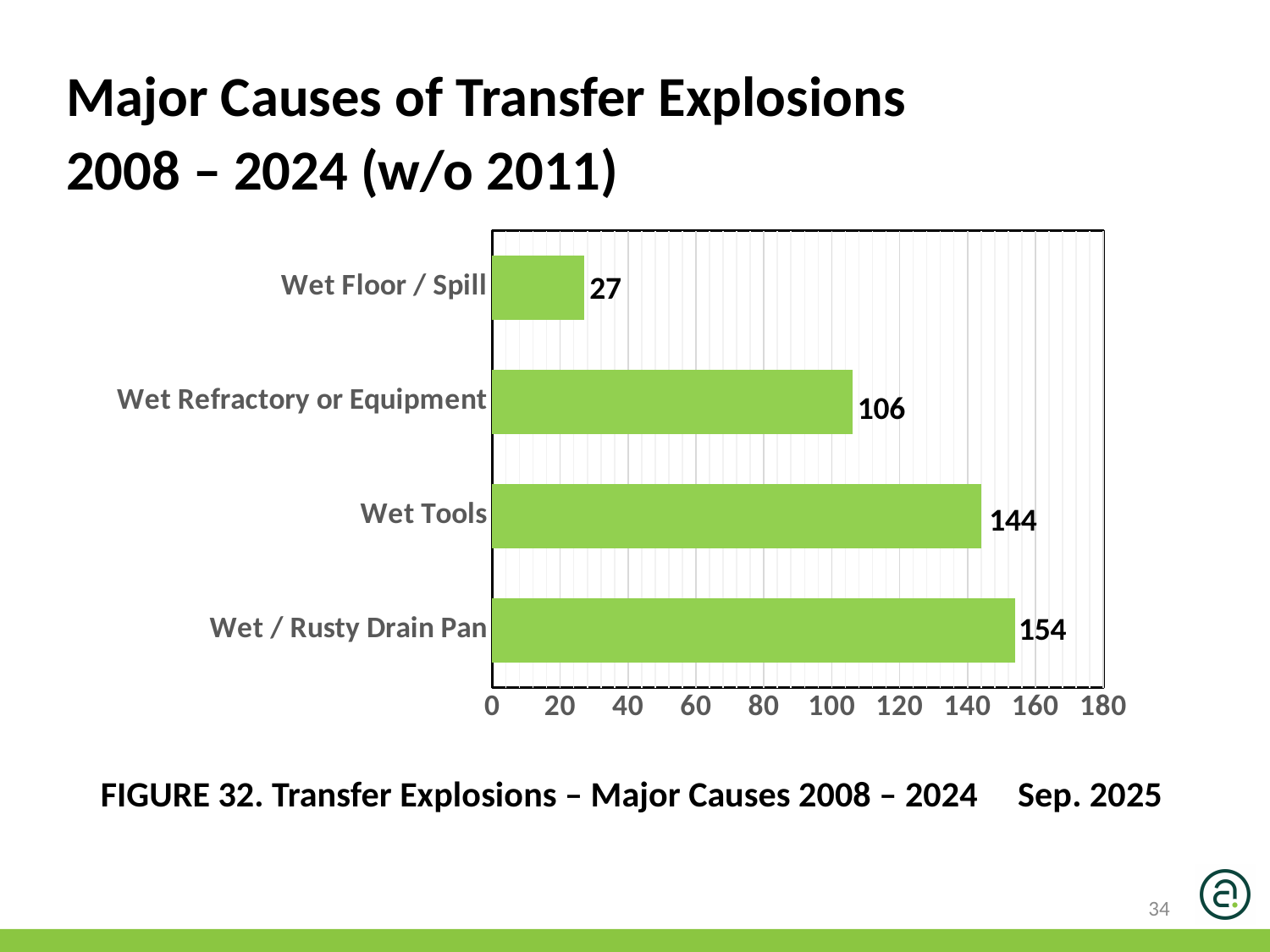
What is the value for Wet Refractory or Equipment? 106 What is the value for Wet Floor / Spill? 27 What kind of chart is shown on the slide? Bar chart How many causes are shown in the chart? 4 Is the value for Wet Refractory or Equipment greater or less than 100? greater What is the difference between the values for Wet Refractory or Equipment and Wet Floor / Spill? 79 What is the value for Wet / Rusty Drain Pan? 154 Which is larger, the value for Wet Tools or the value for Wet Refractory or Equipment? Wet Tools Which cause has the lowest value? Wet Floor / Spill What is the value for Wet Tools? 144 What is the difference between the values for Wet / Rusty Drain Pan and Wet Tools? 10 Which cause has the highest value? Wet / Rusty Drain Pan